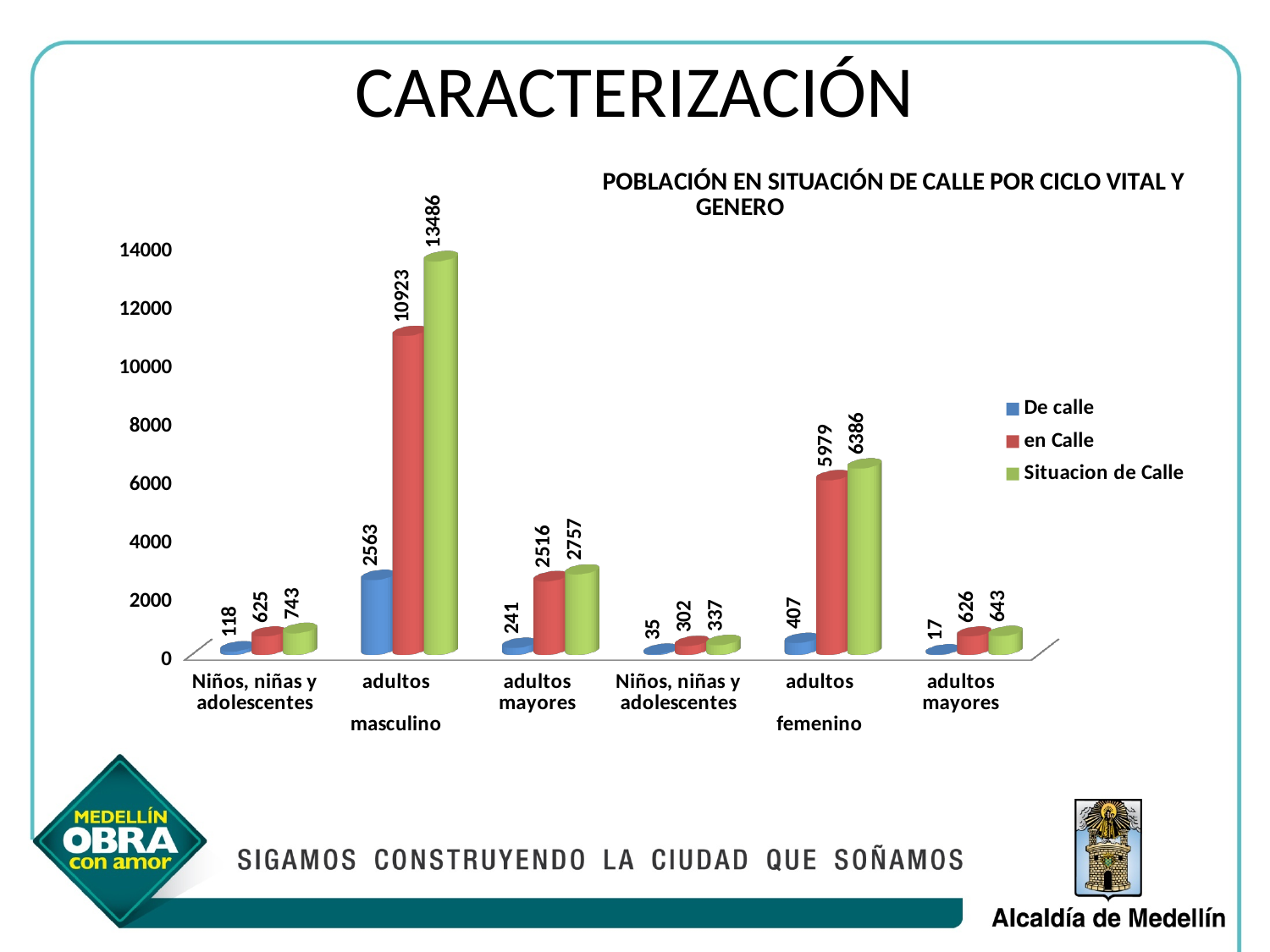
Which is larger: the 'en Calle' value for adultos mayores masculino or for adultos mayores femenino? adultos mayores masculino Which category has the highest 'Situacion de Calle' value? adultos masculino What is the value of 'Situacion de Calle' for adultos masculino? 13486 How many categories are shown on the x axis? 6 What is the difference between the 'Situacion de Calle' values for adultos masculino and adultos femenino? 7100 How many series does the legend list? 3 Is the 'en Calle' value for adultos femenino greater or less than 4000? greater What is the value of 'en Calle' for adultos mayores in the masculino group? 2516 Which category has the lowest 'De calle' value? adultos mayores (femenino) What kind of chart is shown on the slide? bar chart What is the title of the chart? POBLACIÓN EN SITUACIÓN DE CALLE POR CICLO VITAL Y GENERO What is the value of 'De calle' for Niños, niñas y adolescentes in the femenino group? 35